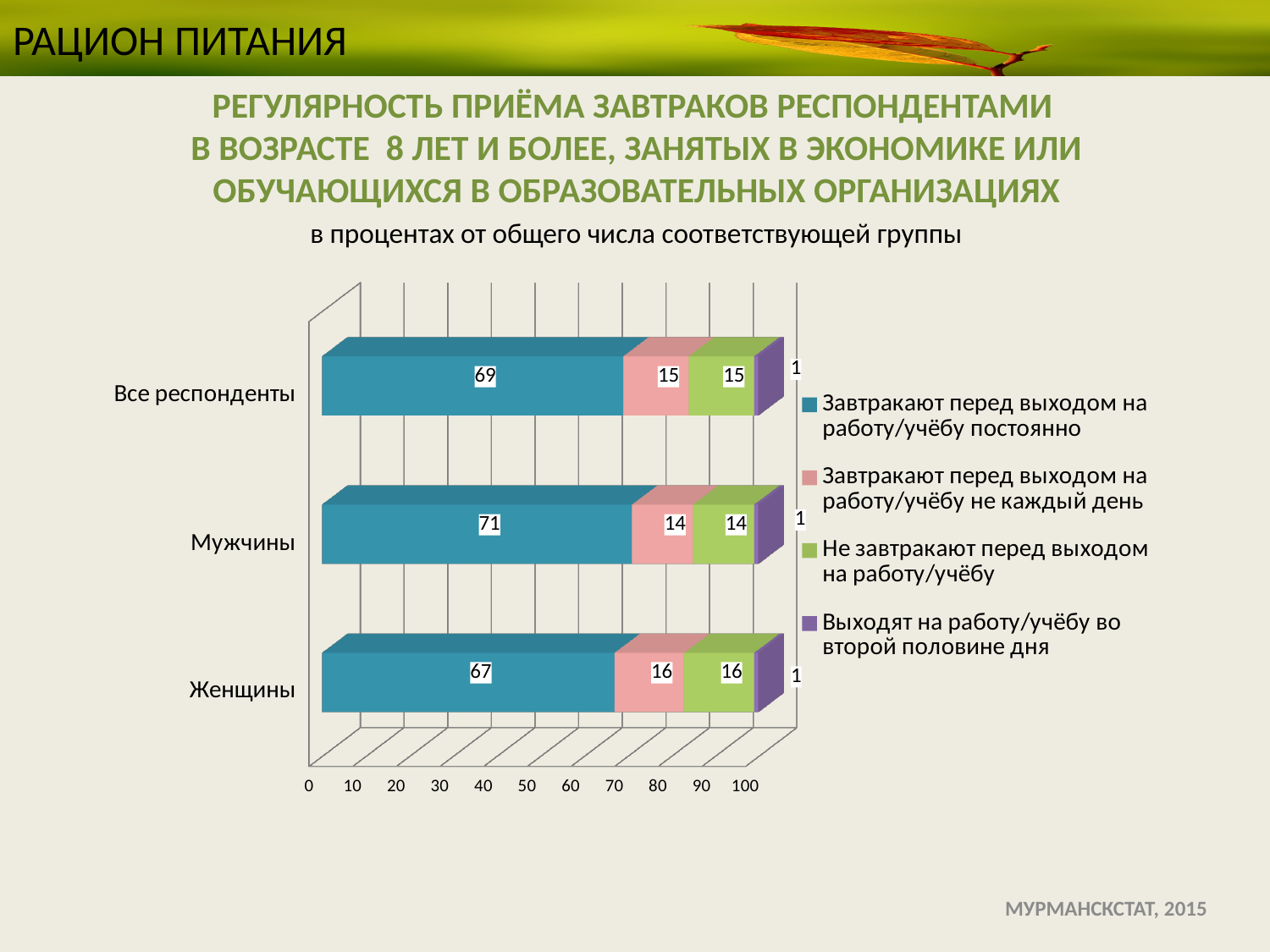
Сколько серий перечислено в легенде диаграммы? 4 Какое значение показано для категории «Все респонденты» по серии «Завтракают перед выходом на работу/учёбу не каждый день»? 15 Сколько категорий показано на диаграмме? 3 Какого типа эта диаграмма? Столбчатая (линейчатая) диаграмма с накоплением Какое значение показано для категории «Мужчины» по серии «Завтракают перед выходом на работу/учёбу постоянно»? 71 В какой категории самое низкое значение по серии «Завтракают перед выходом на работу/учёбу постоянно»? Женщины В какой категории самое высокое значение по серии «Завтракают перед выходом на работу/учёбу постоянно»? Мужчины Какое значение показано для категории «Женщины» по серии «Не завтракают перед выходом на работу/учёбу»? 16 На сколько значение серии «Завтракают перед выходом на работу/учёбу постоянно» у мужчин больше, чем у женщин? 4 У кого значение серии «Не завтракают перед выходом на работу/учёбу» больше: у мужчин или у женщин? Женщины Какое значение показано для категории «Женщины» по серии «Выходят на работу/учёбу во второй половине дня»? 1 Какова сумма всех значений в полосе «Все респонденты»? 100